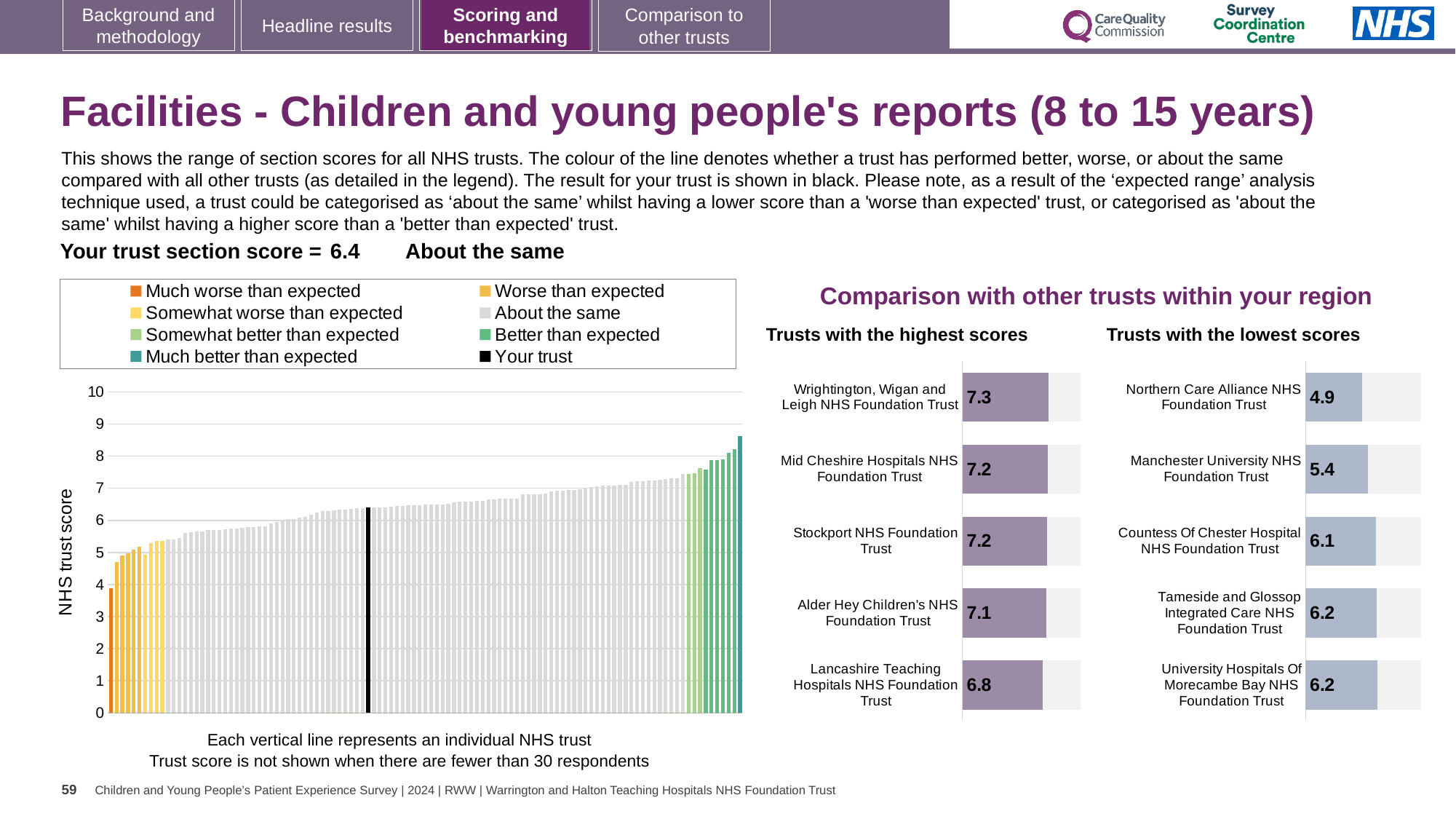
In the 'Trusts with the lowest scores' chart, which trust has the lowest score? Northern Care Alliance NHS Foundation Trust In the 'Trusts with the highest scores' chart, what is the score for Wrightington, Wigan and Leigh NHS Foundation Trust? 7.3 How many entries does the legend above the large chart of NHS trust scores list? 8 In the large chart of NHS trust scores on the left, what is the section score for your trust? 6.4 In the large chart of NHS trust scores on the left, do the values rise or fall from left to right? Rise In the 'Trusts with the highest scores' chart, how many trusts are listed? 5 In the 'Trusts with the highest scores' chart, what is the difference between the scores of Wrightington, Wigan and Leigh NHS Foundation Trust and Lancashire Teaching Hospitals NHS Foundation Trust? 0.5 What kind of chart is the large chart of NHS trust scores on the left? Bar chart In the 'Trusts with the lowest scores' chart, what is the score for Northern Care Alliance NHS Foundation Trust? 4.9 In the 'Trusts with the lowest scores' chart, which has the higher score: Manchester University NHS Foundation Trust or Countess Of Chester Hospital NHS Foundation Trust? Countess Of Chester Hospital NHS Foundation Trust In the 'Trusts with the highest scores' chart, which trust has the lowest score? Lancashire Teaching Hospitals NHS Foundation Trust In the 'Trusts with the lowest scores' chart, what is the difference between the scores of Manchester University NHS Foundation Trust and Northern Care Alliance NHS Foundation Trust? 0.5